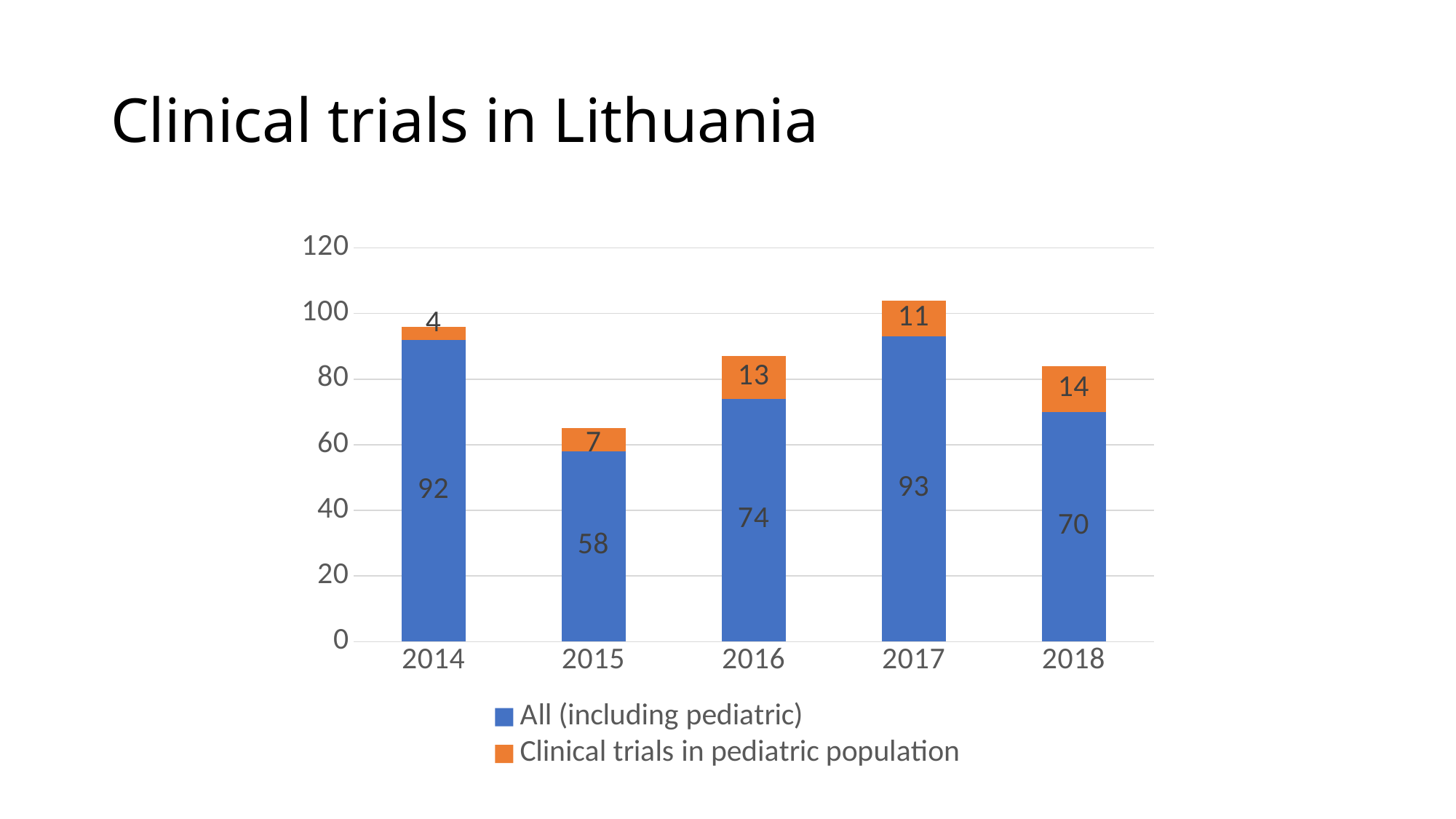
How many series does the legend list? 2 What is the title of the slide? Clinical trials in Lithuania Which is larger: the 'Clinical trials in pediatric population' value for 2016 or for 2017? 2016 Which year has the lowest value for 'Clinical trials in pediatric population'? 2014 What is the total of the stacked bar for 2017? 104 What is the value for 'All (including pediatric)' in 2016? 74 What is the value for 'Clinical trials in pediatric population' in 2018? 14 Which year has the highest value for 'All (including pediatric)'? 2017 How many years are shown on the x axis? 5 What kind of chart is shown on the slide? Stacked bar chart What is the value for 'Clinical trials in pediatric population' in 2014? 4 What is the difference between the 'All (including pediatric)' values for 2014 and 2015? 34